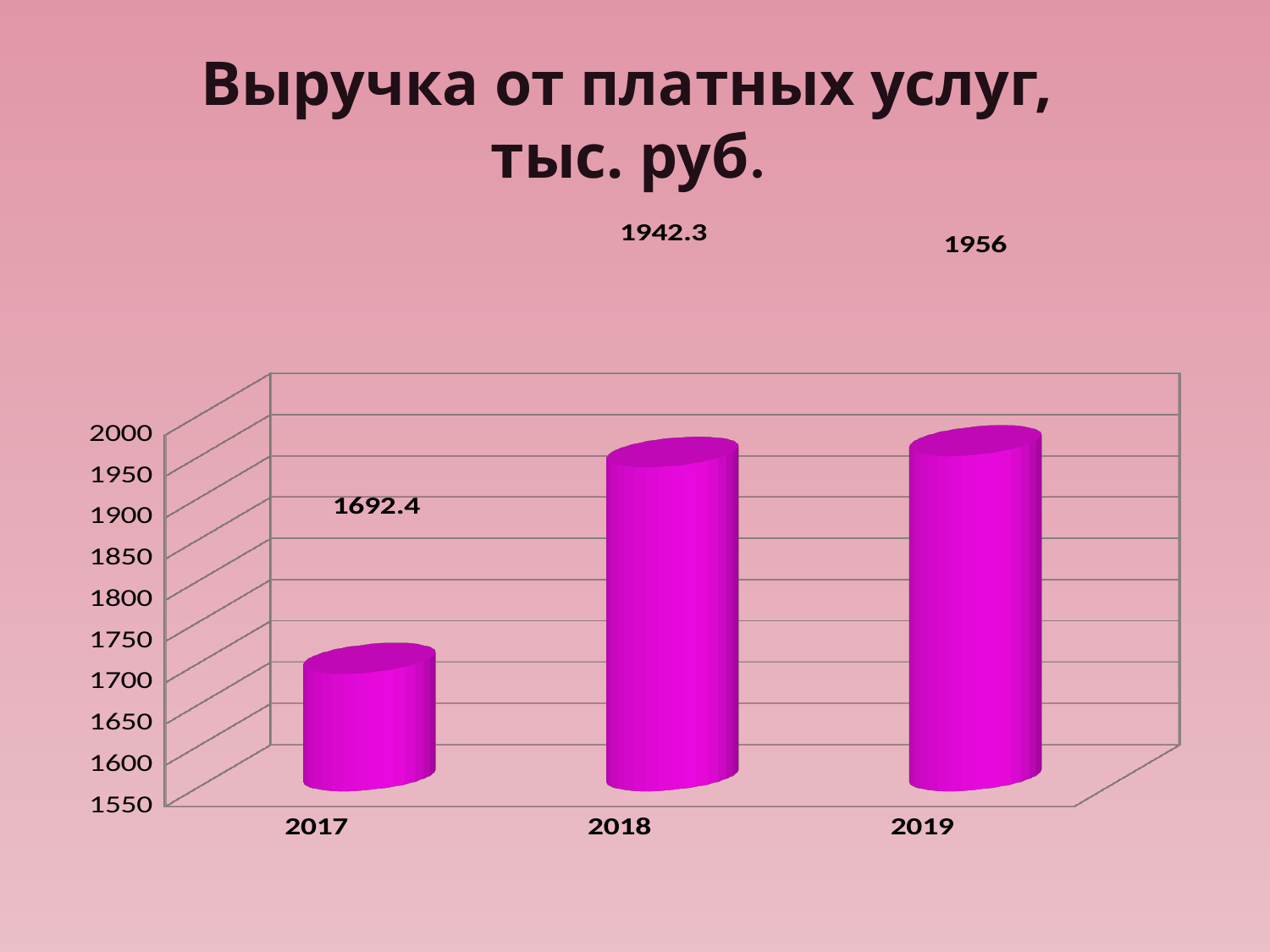
What kind of chart is shown on the slide? bar chart Is the value for 2017 greater or less than 1700? less What is the revenue from paid services in 2017? 1692.4 Which year has higher revenue, 2017 or 2018? 2018 Do the revenue values rise or fall from 2017 to 2019? rise What is the revenue from paid services in 2019? 1956 Which year has the lowest revenue from paid services? 2017 What is the revenue from paid services in 2018? 1942.3 How many years are shown on the chart? 3 What is the difference in revenue between 2019 and 2018? 13.7 Which year has the highest revenue from paid services? 2019 What is the difference in revenue between 2018 and 2017? 249.9